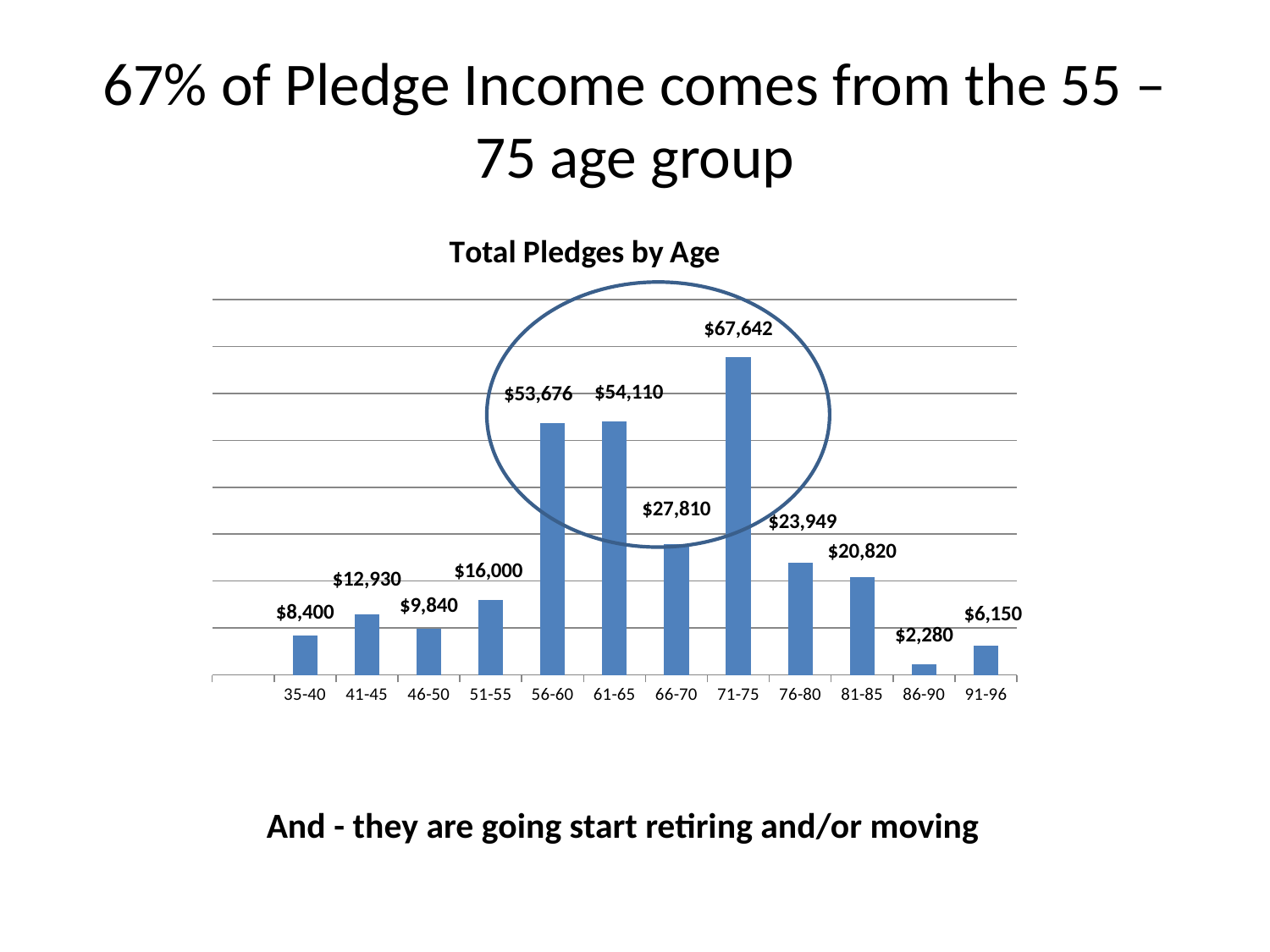
How many age groups are shown on the chart? 12 What is the total pledge value for the 81-85 age group? $20,820 What is the difference in total pledges between the 71-75 and 61-65 age groups? $13,532 Which age group has the highest total pledges? 71-75 What is the title of the chart? Total Pledges by Age What is the difference in total pledges between the 51-55 and 35-40 age groups? $7,600 Which age group has the lowest total pledges? 86-90 What is the total pledge value for the 71-75 age group? $67,642 Which age group has larger total pledges, 41-45 or 46-50? 41-45 What kind of chart is used to show Total Pledges by Age? Bar chart What is the total pledge value for the 35-40 age group? $8,400 Which age group has larger total pledges, 66-70 or 76-80? 66-70